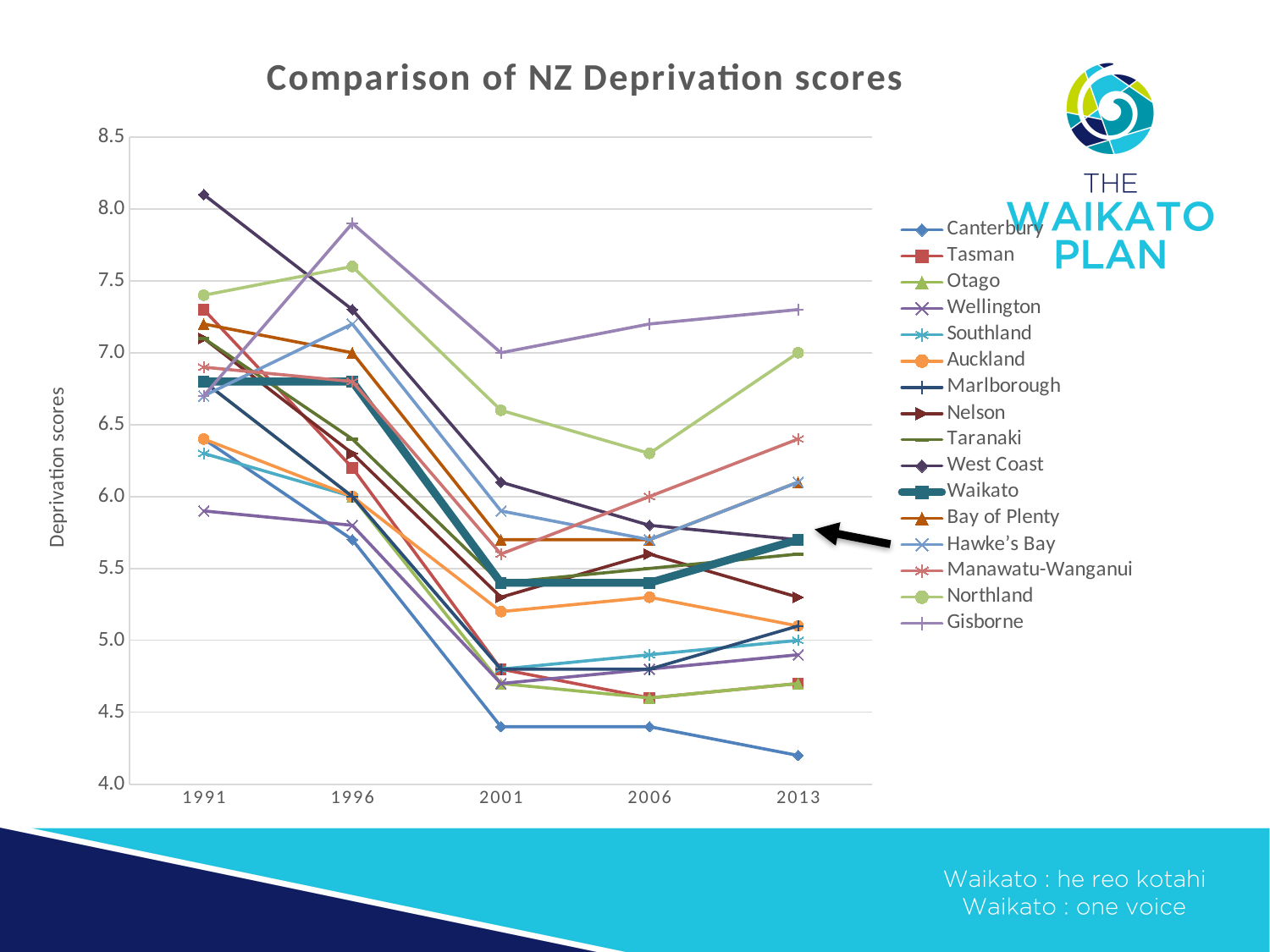
Which region has the highest deprivation score in 2013? Gisborne Is the value for Canterbury in 2013 greater or less than 4.5? less Is the value for Gisborne in 2013 greater or less than 7.0? greater Is the value for Waikato in 2013 greater or less than 5.5? greater What is the title of the chart? Comparison of NZ Deprivation scores Does the Canterbury line rise or fall from 1991 to 2013? fall Which region has the lowest deprivation score in 2013? Canterbury Which series is drawn with the thick line that the black arrow points to? Waikato How many series does the legend list? 16 How many years are shown on the x axis? 5 Which region has the highest deprivation score in 1991? West Coast What type of chart is shown on the slide? line chart